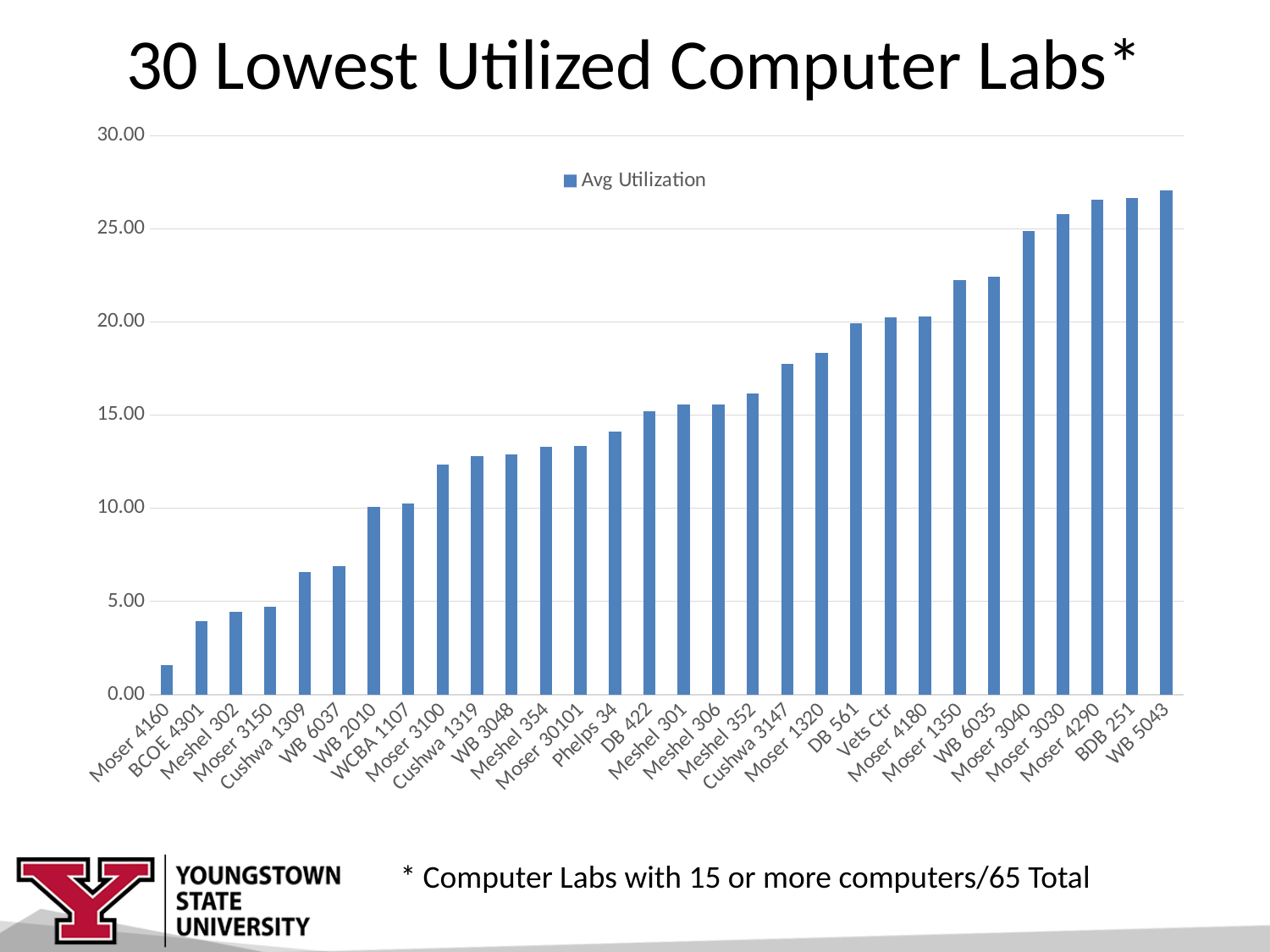
Which computer lab has the highest average utilization? WB 5043 Is the value for Moser 3100 greater or less than 10.00? greater Is the value for WB 5043 greater or less than 25.00? greater What type of chart is shown on the slide? bar chart Do the values rise or fall moving left to right along the x axis? rise Is the value for Moser 1320 greater or less than 20.00? less How many series does the legend list? 1 How many computer labs are plotted on the chart? 30 Which computer lab has the lowest average utilization? Moser 4160 Which has the larger average utilization, Cushwa 3147 or DB 561? DB 561 What is the name of the series shown in the legend? Avg Utilization